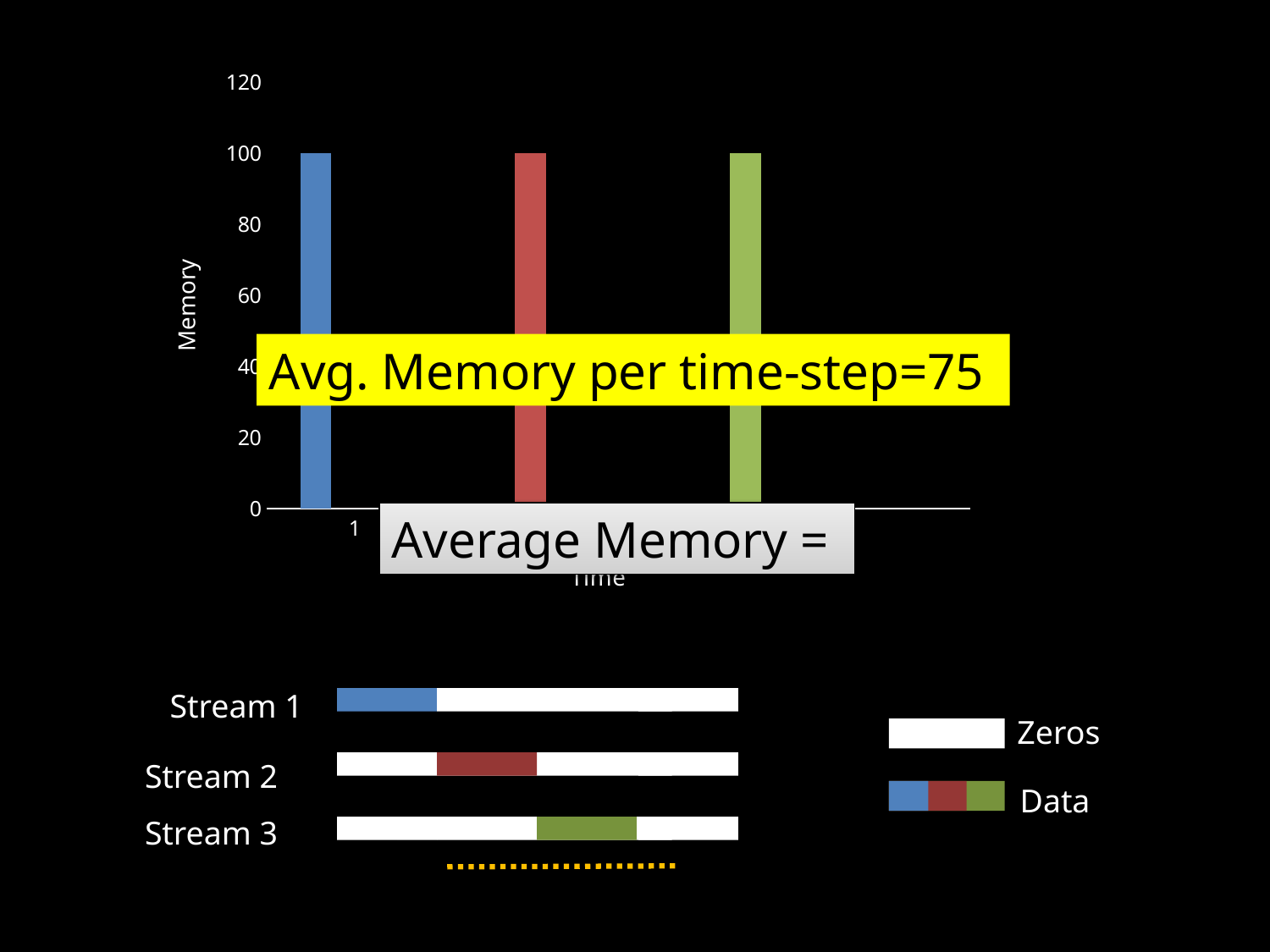
What is the value of the green bar in the chart? 100 What is the label of the y axis of the chart? Memory What is the highest tick value shown on the y axis? 120 Is the value of the green bar greater or less than 120? less What is the value of the red bar in the chart? 100 How many bars are plotted in the chart? 3 What is the Memory value for category 1 on the x axis? 100 What kind of chart is shown on the slide? bar chart What is the value of the first (blue) bar in the chart? 100 Is the value of the red bar greater or less than 80? greater